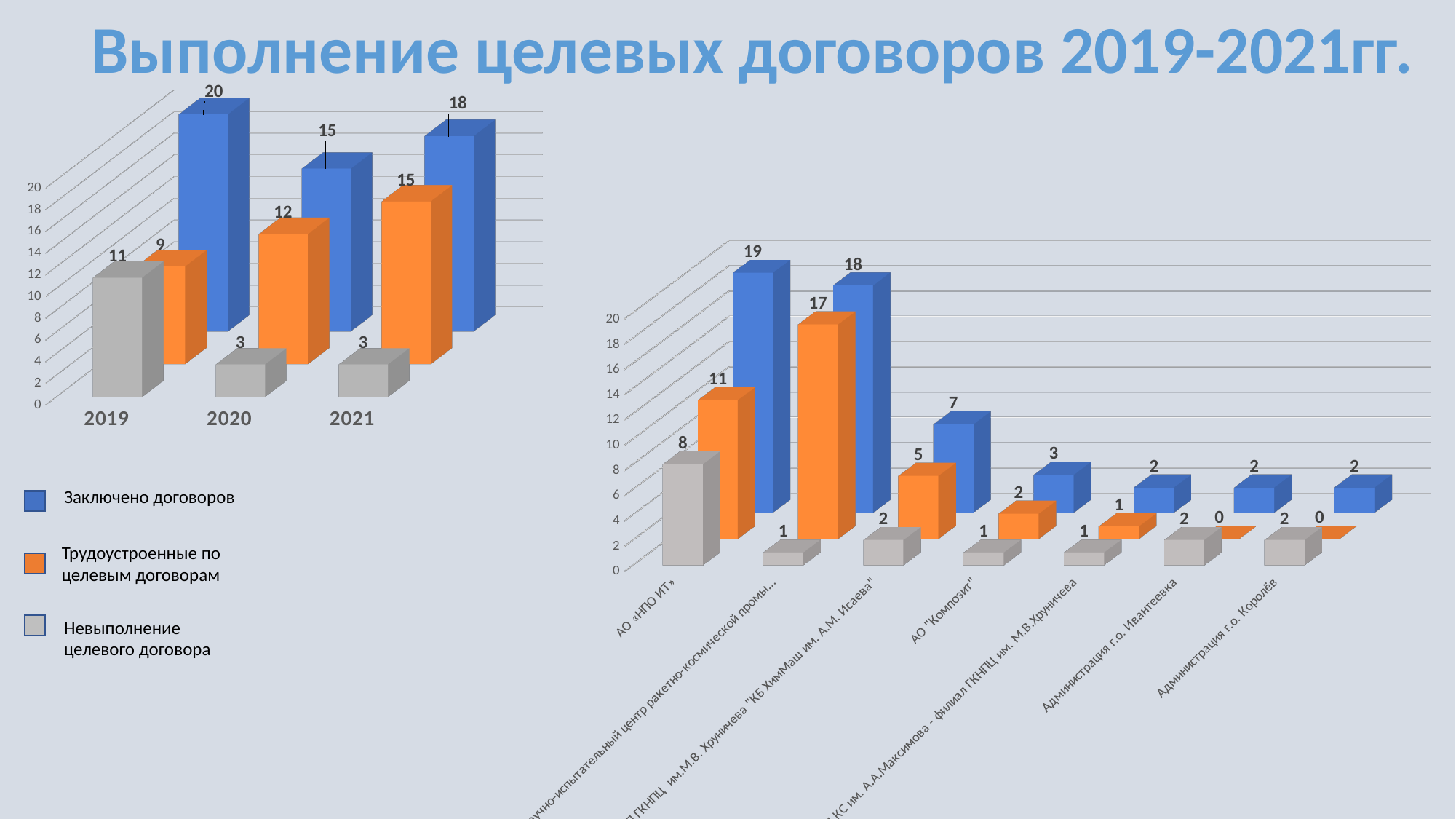
On the right chart, what is the value of Трудоустроенные по целевым договорам for Администрация г.о. Королёв? 0 On the right chart, what is the value of Трудоустроенные по целевым договорам for АО "Композит"? 2 How many series does the legend list? 3 On the left chart, what is the value of Трудоустроенные по целевым договорам for 2021? 15 On the right chart, what is the value of Заключено договоров for АО «НПО ИТ»? 19 On the left chart, which year has the highest value for Заключено договоров? 2019 On the left chart, what is the value of Заключено договоров for 2019? 20 On the left chart, does the value of Трудоустроенные по целевым договорам rise or fall from 2019 to 2021? rise What kind of chart is the right chart? bar chart On the left chart, what is the value of Невыполнение целевого договора for 2020? 3 On the left chart, what is the difference between Заключено договоров and Трудоустроенные по целевым договорам in 2020? 3 On the right chart, how many organizations are shown on the x axis? 7